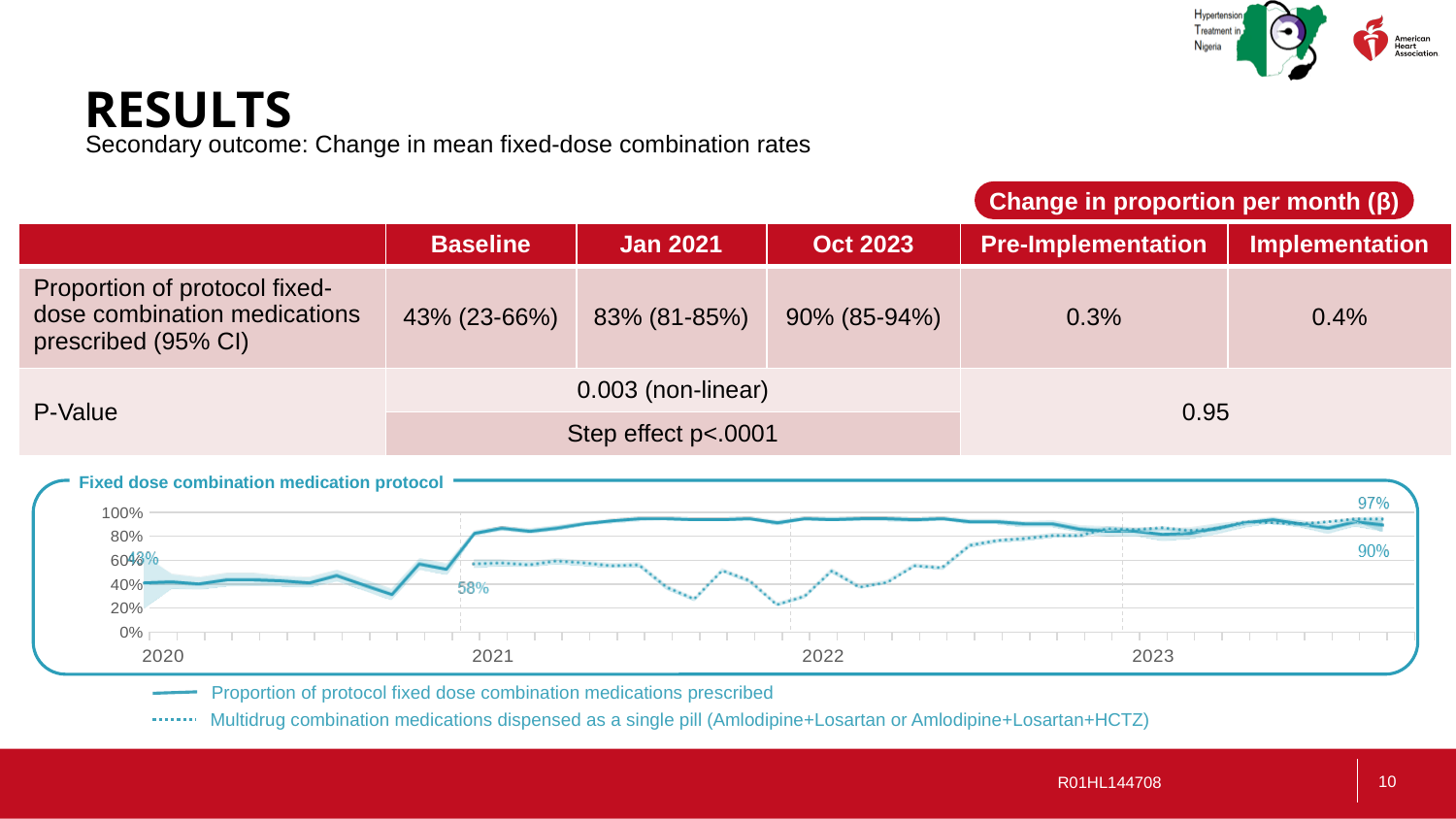
What is the title of the chart? Fixed dose combination medication protocol Does the solid line for proportion of protocol fixed dose combination medications prescribed rise or fall overall from 2020 to 2023? rise Is the value of the dotted line at the start of 2022 greater or less than 60%? less What value is labelled on the dotted line (Multidrug combination medications dispensed as a single pill) at the start of 2021? 58% How many series does the legend of the chart list? 2 Is the solid line higher in 2022 or in 2020? 2022 Which legend entry is shown with a dotted line? Multidrug combination medications dispensed as a single pill (Amlodipine+Losartan or Amlodipine+Losartan+HCTZ) What value is labelled at the start of the solid line (Proportion of protocol fixed dose combination medications prescribed) in 2020? 43% How many years are labelled on the x axis of the chart? 4 What type of chart is shown on the slide? line chart Is the value of the solid line during 2020 greater or less than 60%? less Is the value of the solid line during 2023 greater or less than 80%? greater